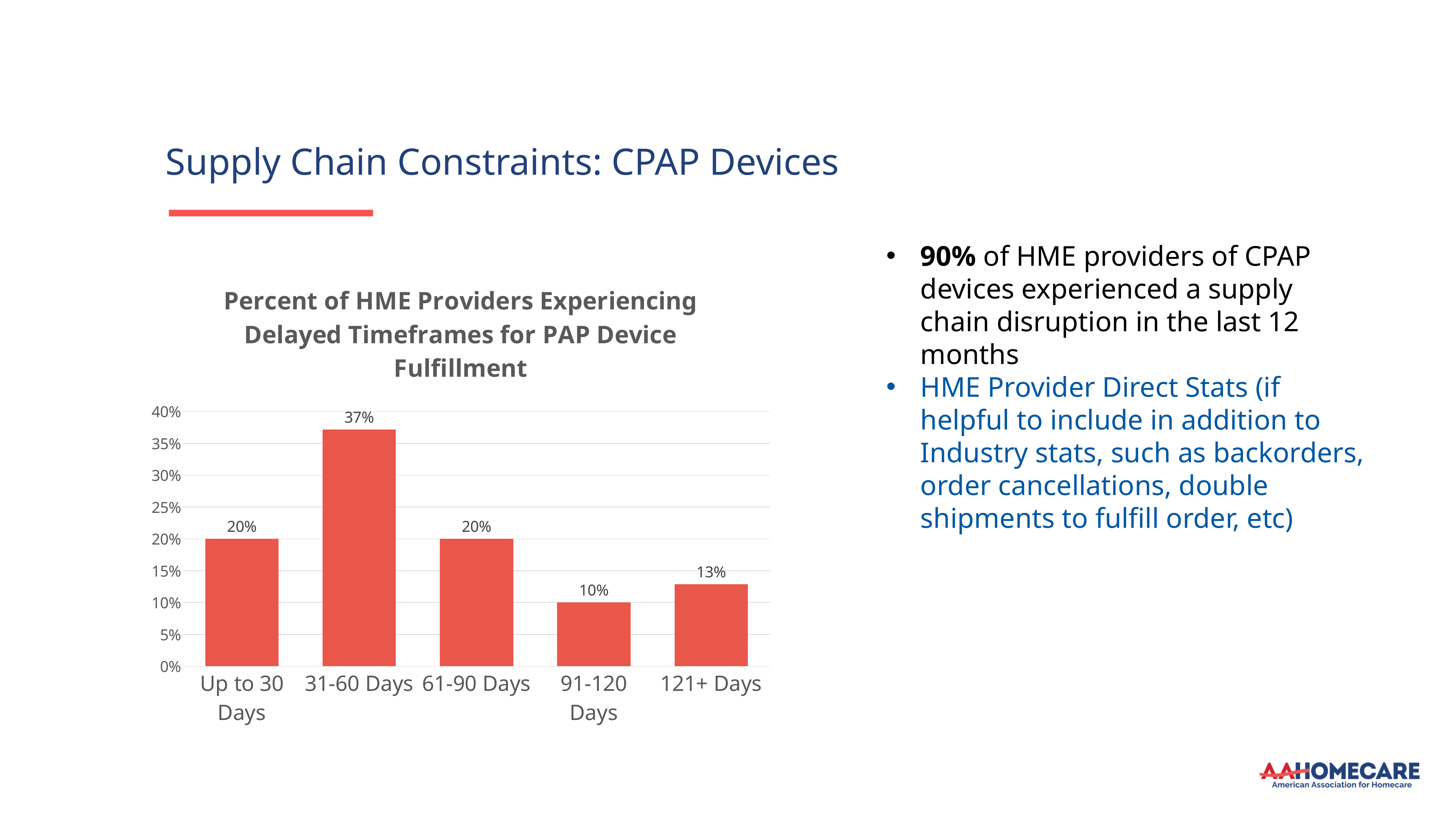
Which is larger, the value for 121+ Days or the value for 91-120 Days? 121+ Days What is the difference between the values for 31-60 Days and 61-90 Days? 17% What is the value for the 91-120 Days category? 10% Which category has the lowest value? 91-120 Days What is the title of the chart? Percent of HME Providers Experiencing Delayed Timeframes for PAP Device Fulfillment What kind of chart is shown on the slide? bar chart Which category has the highest value? 31-60 Days What percentage of HME providers experienced delayed timeframes of 31-60 Days? 37% How many categories are shown on the x axis? 5 What is the value for the 121+ Days category? 13% What is the value for the Up to 30 Days category? 20% Is the value for 31-60 Days greater or less than 35%? greater